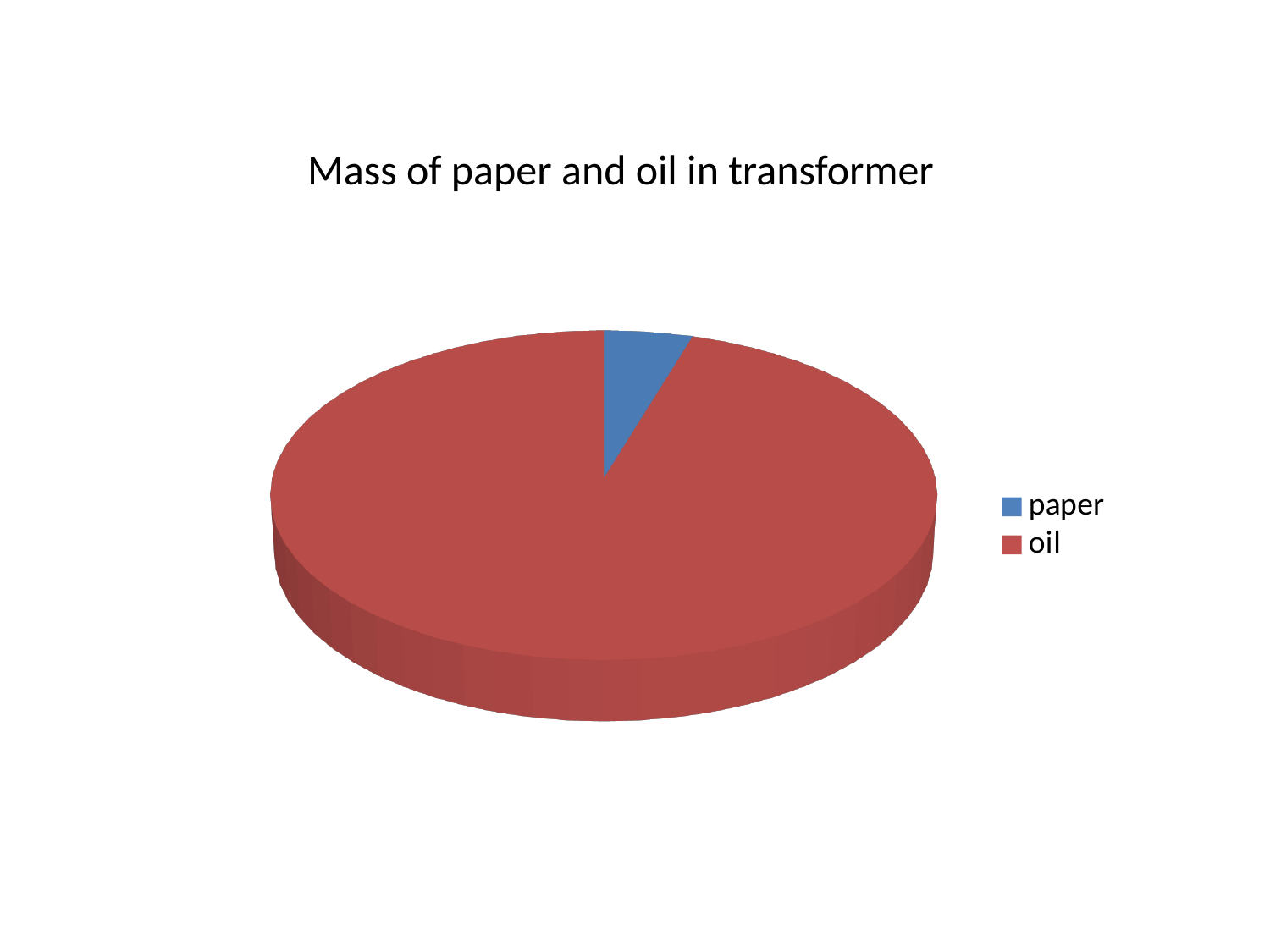
What kind of chart is shown on the slide? pie chart How many slices does the pie chart have? 2 Which category has the smallest slice of the pie? paper What colour is the slice for oil? red What is the title of the chart? Mass of paper and oil in transformer How many entries does the legend list? 2 Which is larger, the slice for paper or the slice for oil? oil Does the slice for oil take up more or less than half of the pie? more Which category has the largest slice of the pie? oil